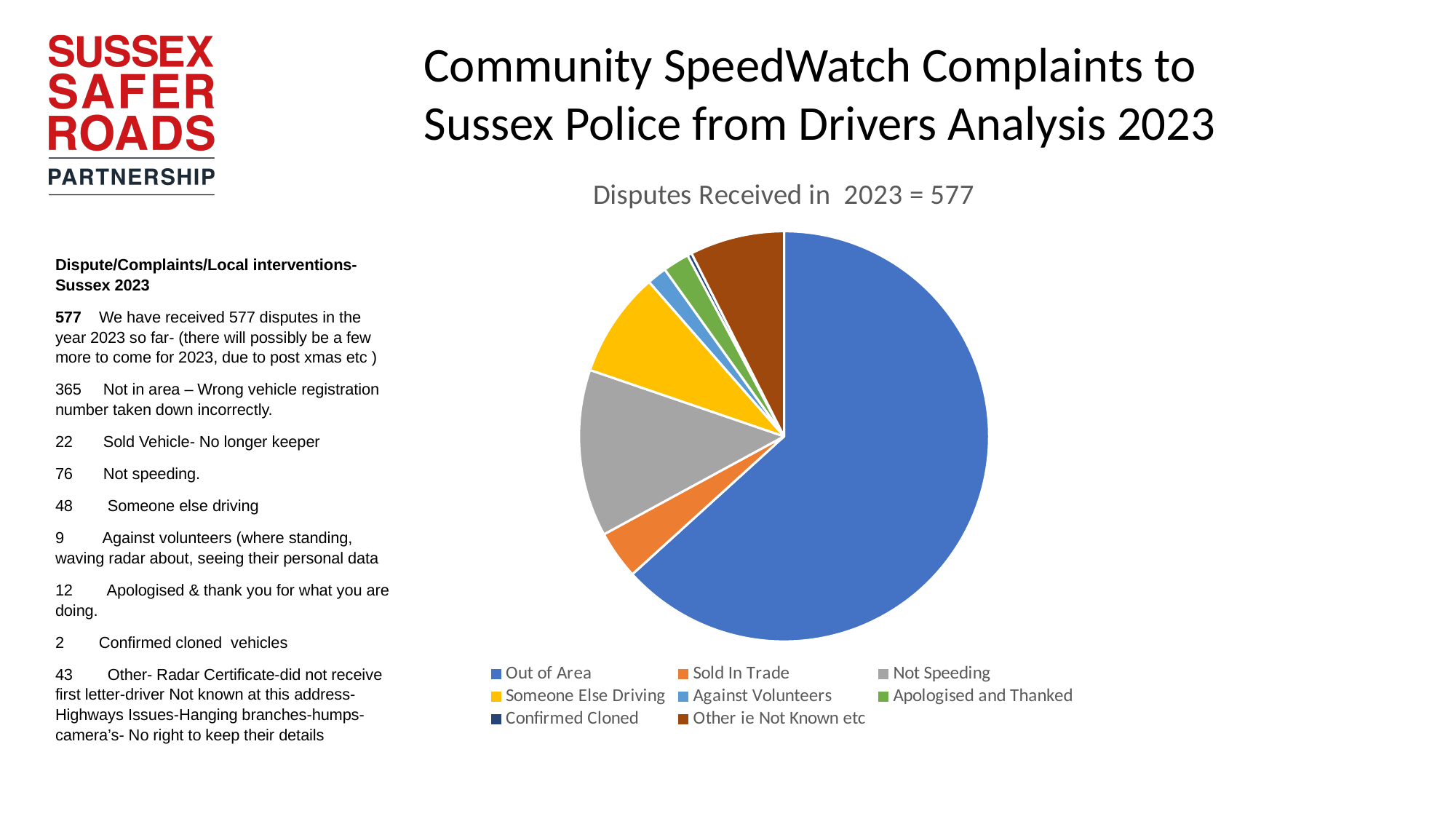
How many categories does the pie chart's legend list? 8 Does the Out of Area slice make up more or less than half of the pie? more Which slice is larger, Other ie Not Known etc or Apologised and Thanked? Other ie Not Known etc Which slice is larger, Someone Else Driving or Against Volunteers? Someone Else Driving What colour is the Out of Area slice in the pie chart? Blue What is the title of the pie chart? Disputes Received in 2023 = 577 Which category has the largest slice of the pie chart? Out of Area What kind of chart is shown on the slide? Pie chart Which category has the smallest slice of the pie chart? Confirmed Cloned Which slice is larger, Not Speeding or Someone Else Driving? Not Speeding